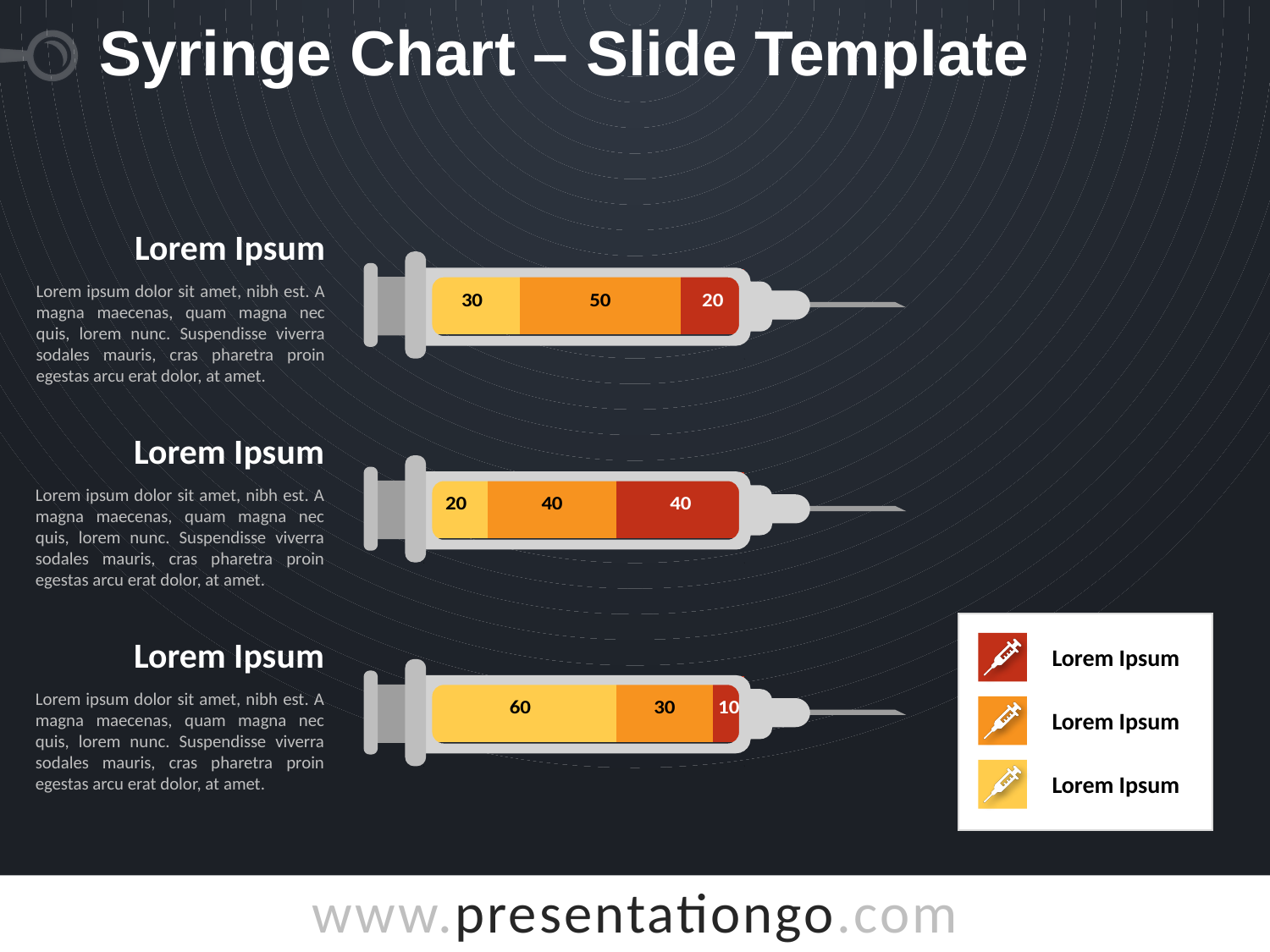
What value is shown on the yellow segment of the top syringe? 30 Which segment of the bottom syringe has the largest value? The yellow segment (60) What value is shown on the orange segment of the top syringe? 50 Which segment of the top syringe has the smallest value? The red segment (20) What is the difference between the orange and red segments of the bottom syringe? 20 What is the total of the three segments in the middle syringe? 100 What value is shown on the red segment of the middle syringe? 40 Which is larger: the yellow segment of the top syringe or the yellow segment of the middle syringe? The yellow segment of the top syringe (30) What value is shown on the yellow segment of the bottom syringe? 60 How many syringe bars are shown on the slide? 3 What is the total of the three segments in the top syringe? 100 What value is shown on the red segment of the bottom syringe? 10